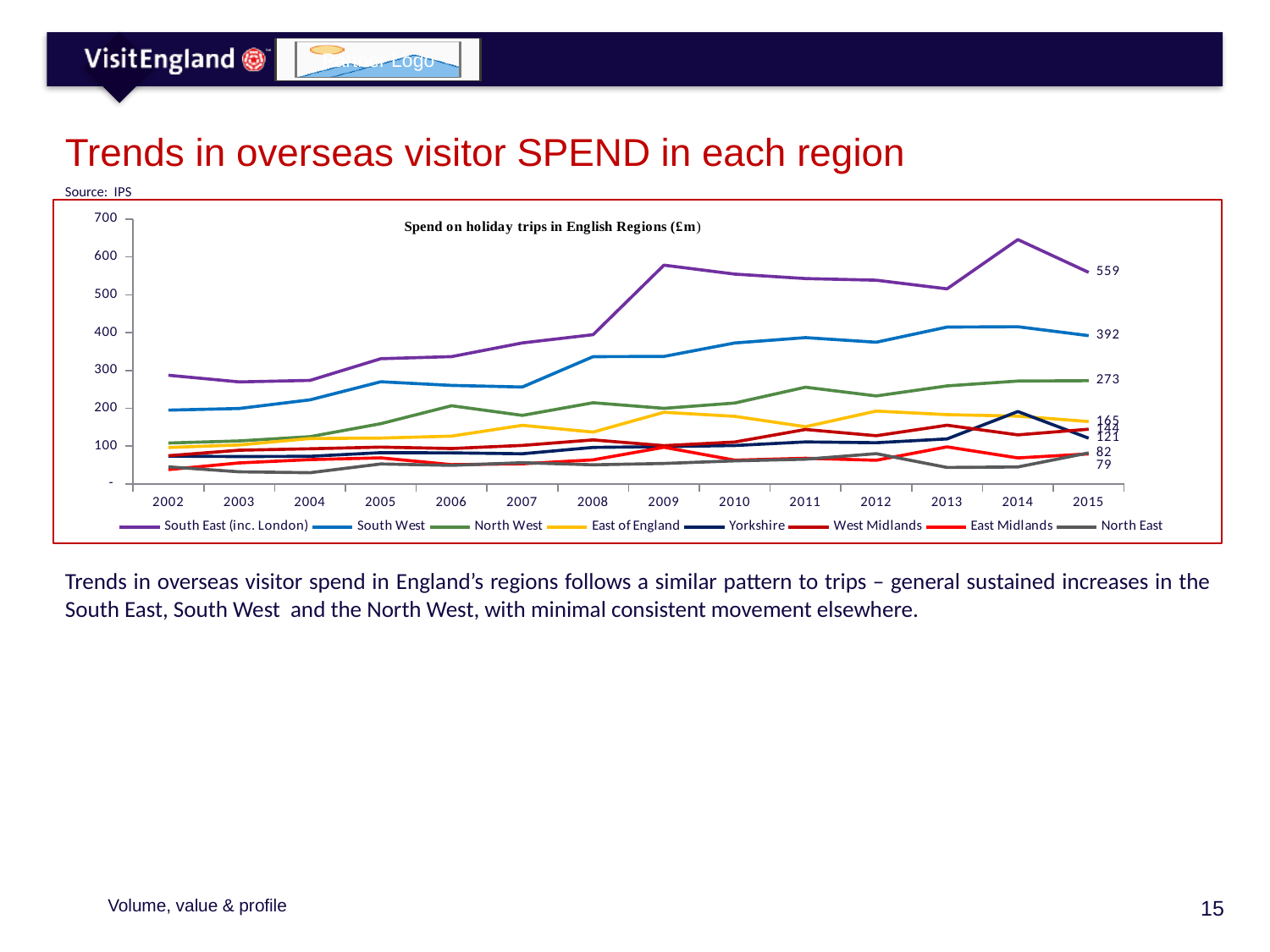
How many series does the legend list? 8 What is the 2015 value for South West? 392 What kind of chart is shown on the slide? line chart What is the 2015 value for South East (inc. London)? 559 How many years are plotted along the x axis? 14 What is the title of the chart? Spend on holiday trips in English Regions (£m) Is the value for South West in 2002 greater or less than 300? less What is the 2015 value for North West? 273 In 2015, which is larger: South West or North West? South West Which region has the highest spend in 2015? South East (inc. London) Is the value for South East (inc. London) in 2014 greater or less than 600? greater What is the difference between the 2015 values for South East (inc. London) and South West? 167